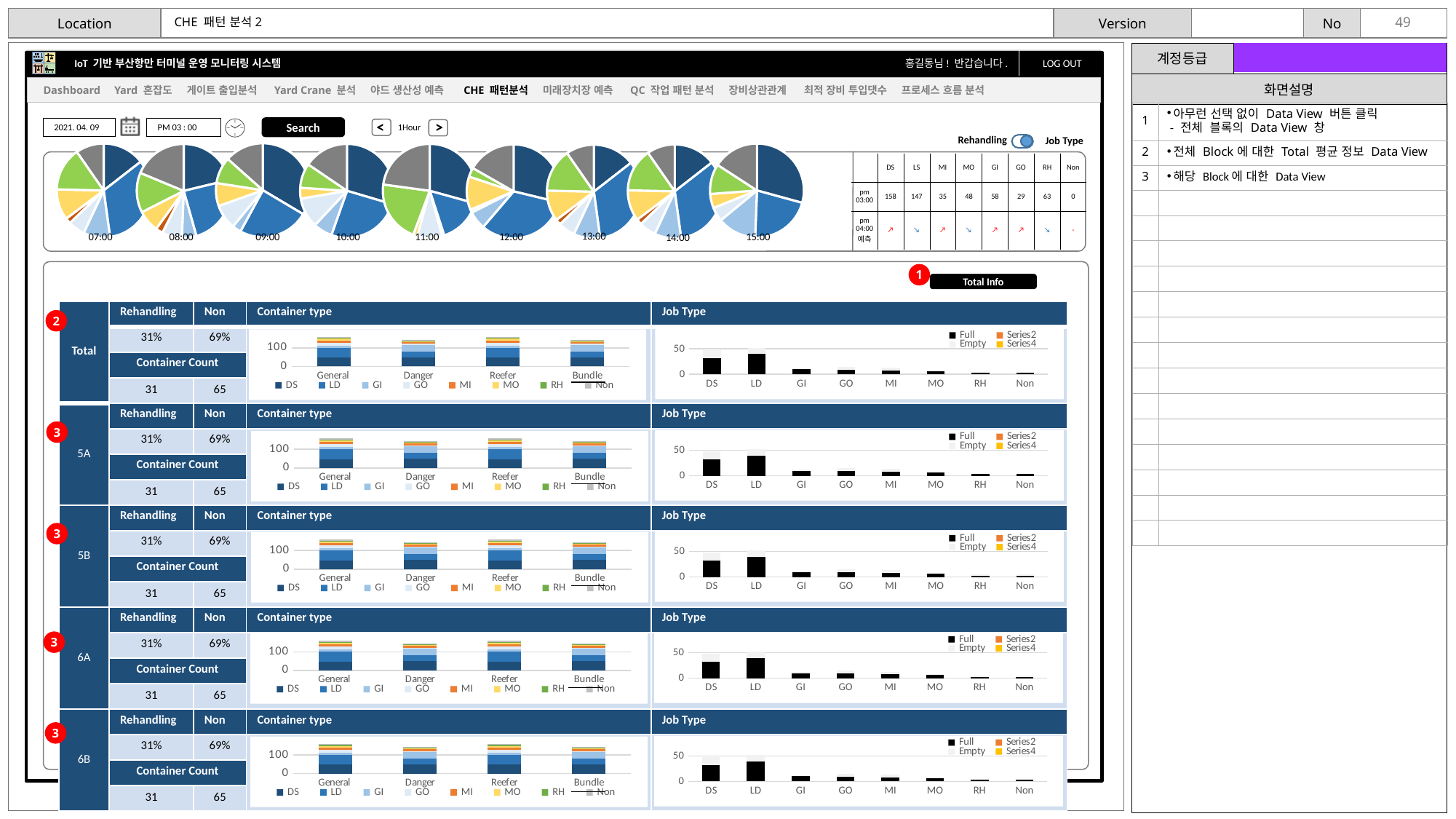
How many series does the legend of the 'Job Type' chart in the Total row list? 4 In the 'Job Type' chart in the Total row, which category has the highest value? LD How many categories are shown on the x axis of the 'Container type' chart in the Total row? 4 How many pie charts are shown in the row of charts at the top of the screen (labelled 07:00 to 15:00)? 9 What are the legend entries of the 'Job Type' chart in the 5A row? Full, Empty, Series2, Series4 How many series does the legend of the 'Container type' chart in the Total row list? 8 How many categories are shown on the x axis of the 'Job Type' chart in the Total row? 8 What kind of chart is the 'Job Type' chart in the Total row? bar chart In the 'Job Type' chart in the Total row, which is larger, the value for LD or the value for GI? LD What kind of chart is the 'Container type' chart in the Total row? stacked bar chart In the 'Job Type' chart in the Total row, is the value for DS greater or less than 50? less